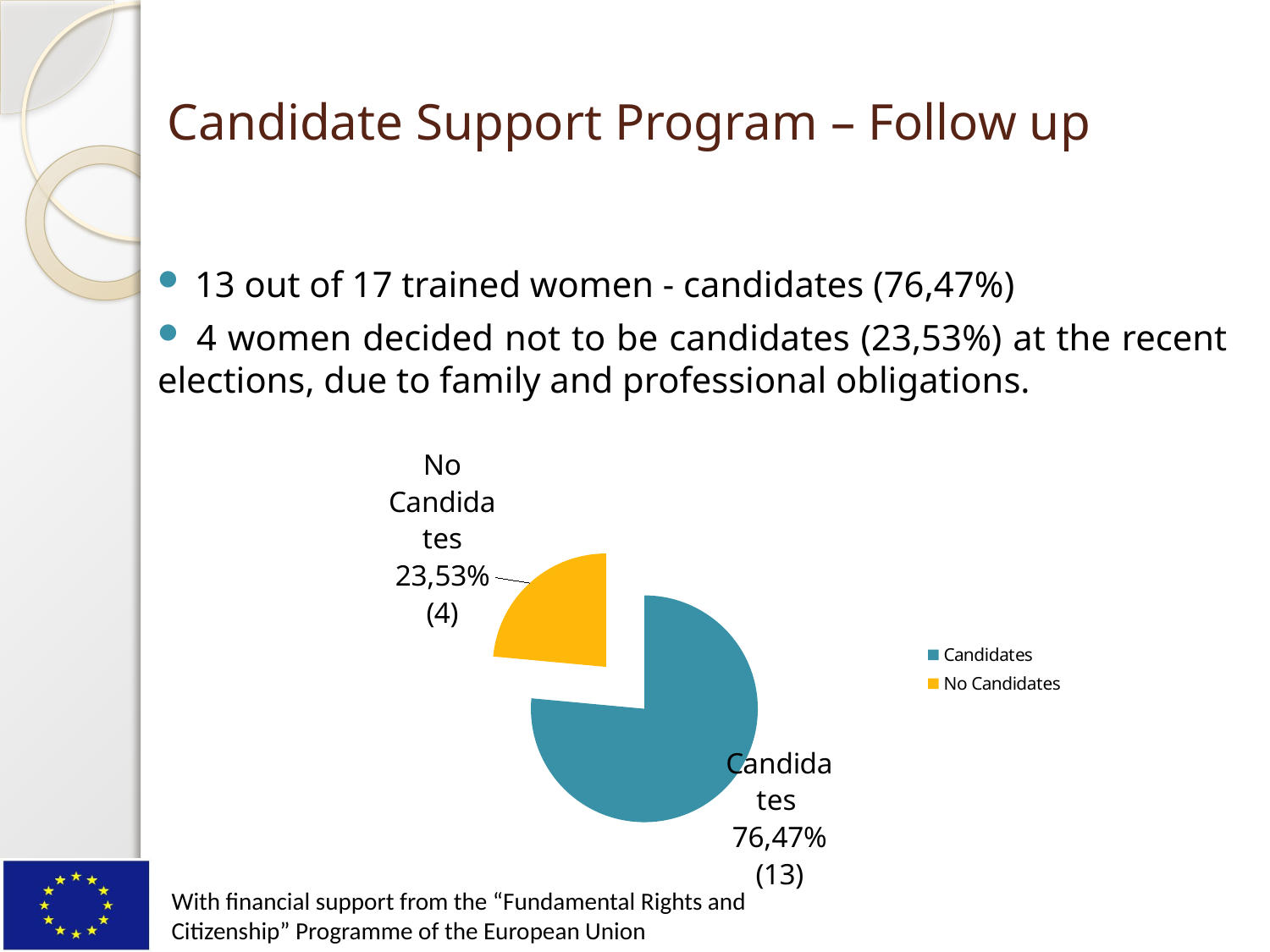
How many slices does the pie chart have? 2 What colour is the No Candidates slice? yellow Which is larger, the Candidates slice or the No Candidates slice? Candidates Which slice of the pie is the smallest? No Candidates Which slice of the pie is the largest? Candidates What is the difference in count between the Candidates and No Candidates slices? 9 What percentage share does the Candidates slice have? 76,47% What percentage share does the No Candidates slice have? 23,53% What kind of chart is shown on the slide? pie chart How many women are in the No Candidates slice? 4 How many women are in the Candidates slice? 13 How many entries does the legend list? 2